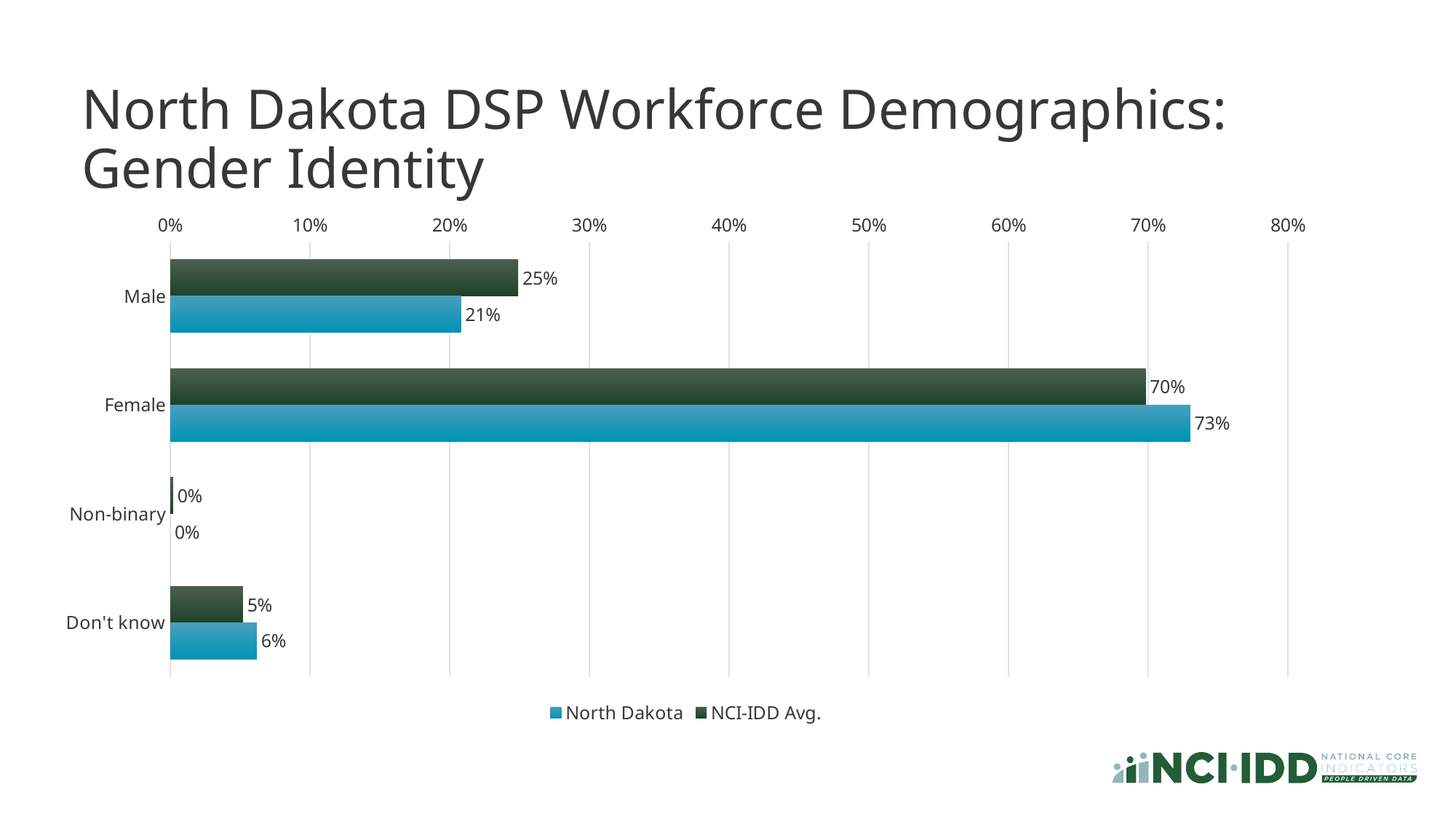
What is the title of the chart? North Dakota DSP Workforce Demographics: Gender Identity What is the NCI-IDD Avg. value for Male? 25% What is the North Dakota value for Female? 73% How many categories are shown on the chart? 4 What is the NCI-IDD Avg. value for Non-binary? 0% How many series does the legend list? 2 What kind of chart is shown on the slide? Bar chart What is the difference between the North Dakota and NCI-IDD Avg. values for Male? 4% What is the North Dakota value for Don't know? 6% For Female, which is larger: the North Dakota value or the NCI-IDD Avg. value? North Dakota Which category has the highest North Dakota value? Female Which category has the lowest NCI-IDD Avg. value? Non-binary